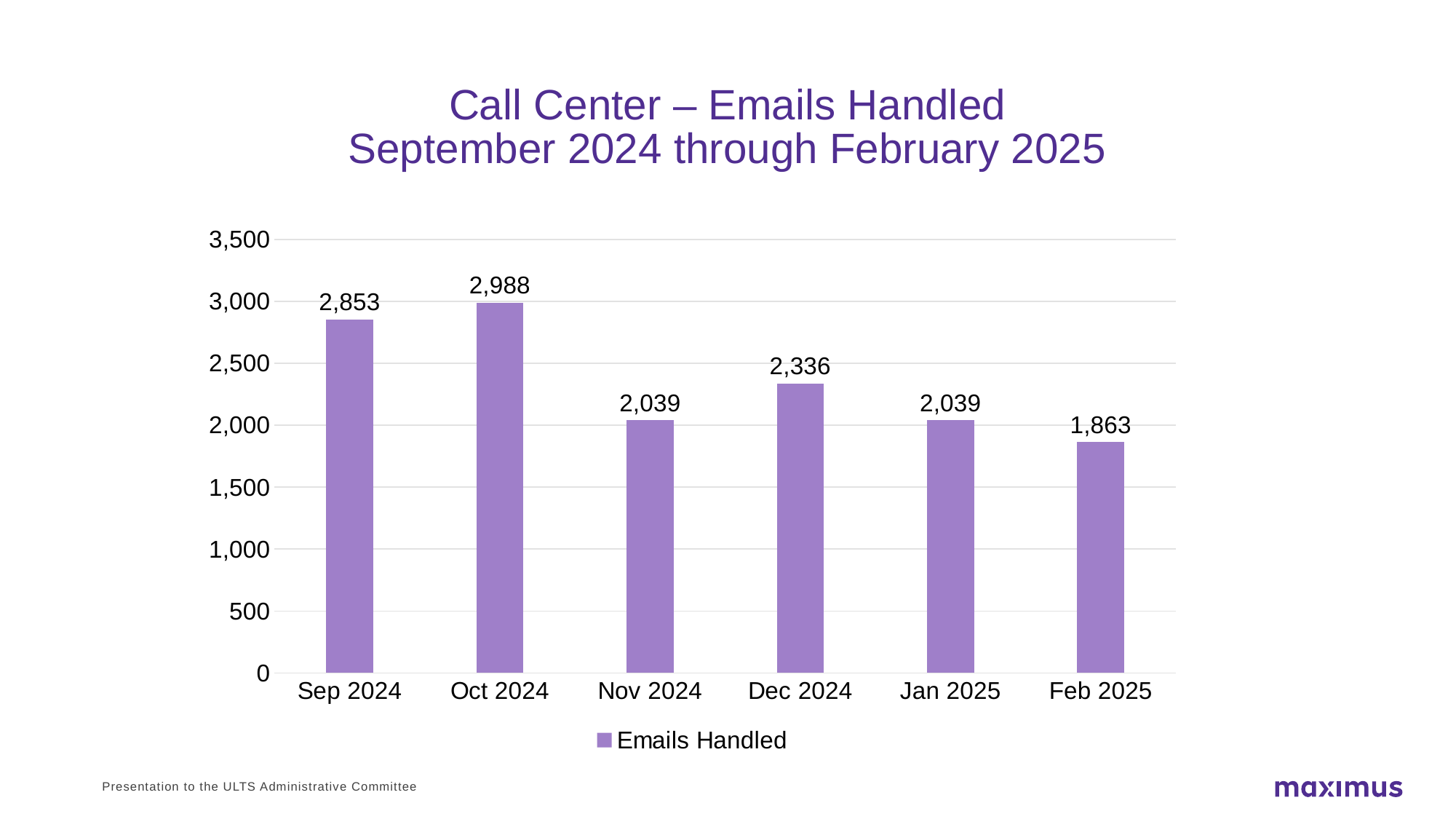
Which month has the highest number of emails handled? Oct 2024 What is the difference between the emails handled in Oct 2024 and Sep 2024? 135 How many emails were handled in Oct 2024? 2,988 What is the difference between the emails handled in Dec 2024 and Feb 2025? 473 What is the value for Feb 2025? 1,863 Is the value for Jan 2025 greater or less than 2,500? less What series name does the legend show? Emails Handled Which is larger, the value for Sep 2024 or the value for Dec 2024? Sep 2024 Which month has the lowest number of emails handled? Feb 2025 What kind of chart is shown on the slide? Bar chart How many months are shown on the x axis? 6 How many emails were handled in Dec 2024? 2,336